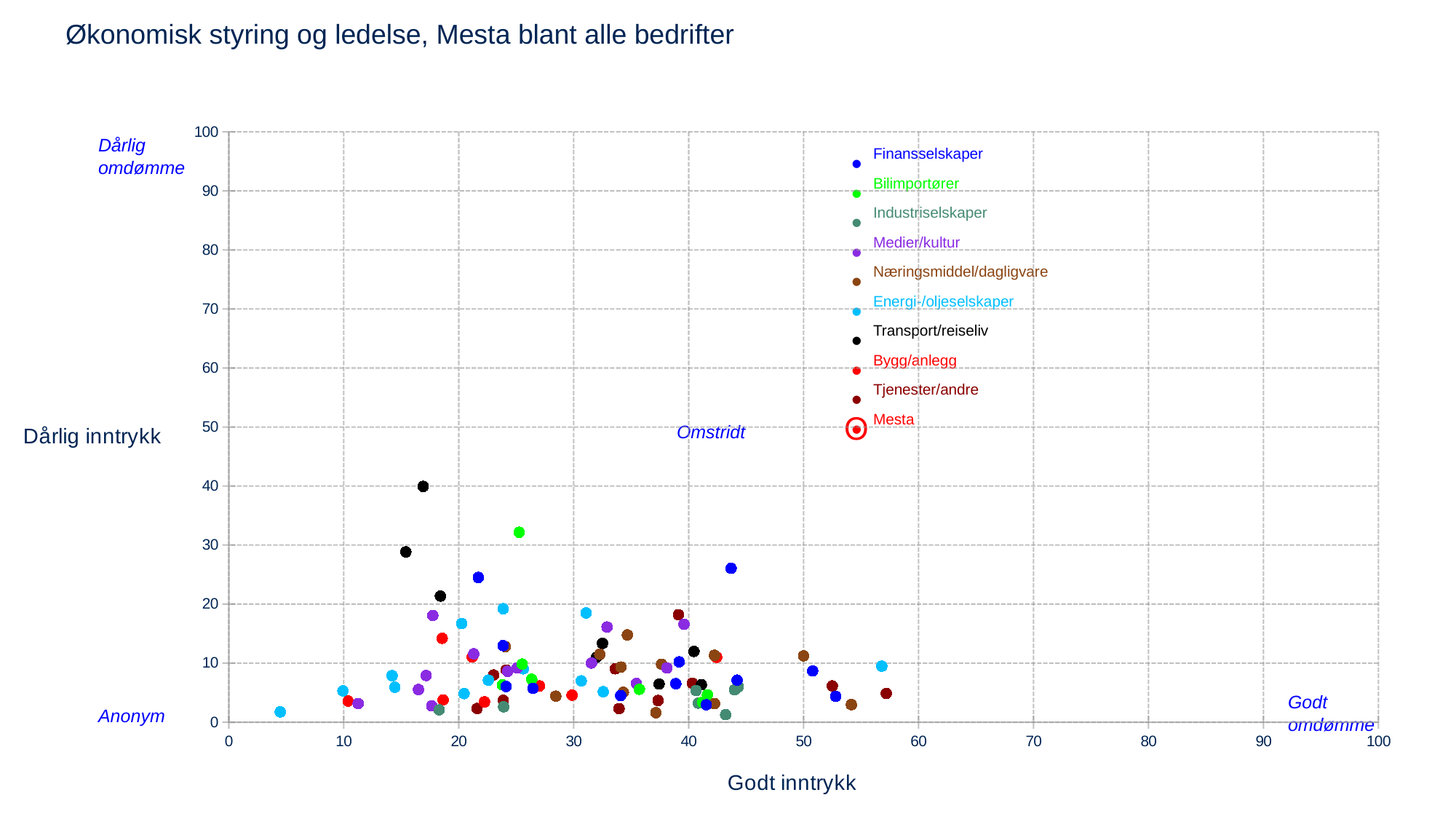
What kind of chart is shown on the slide? scatter chart Which legend entry is shown with a red circled marker instead of a plain dot? Mesta How many entries does the legend list? 10 What is the maximum value shown on the y axis? 100 Is the rightmost plotted point greater or less than 60 on the x axis? less Is the highest plotted point greater or less than 50 on the y axis? less What is the maximum value shown on the x axis? 100 What is the title of the chart? Økonomisk styring og ledelse, Mesta blant alle bedrifter Is the leftmost plotted point greater or less than 10 on the x axis? less